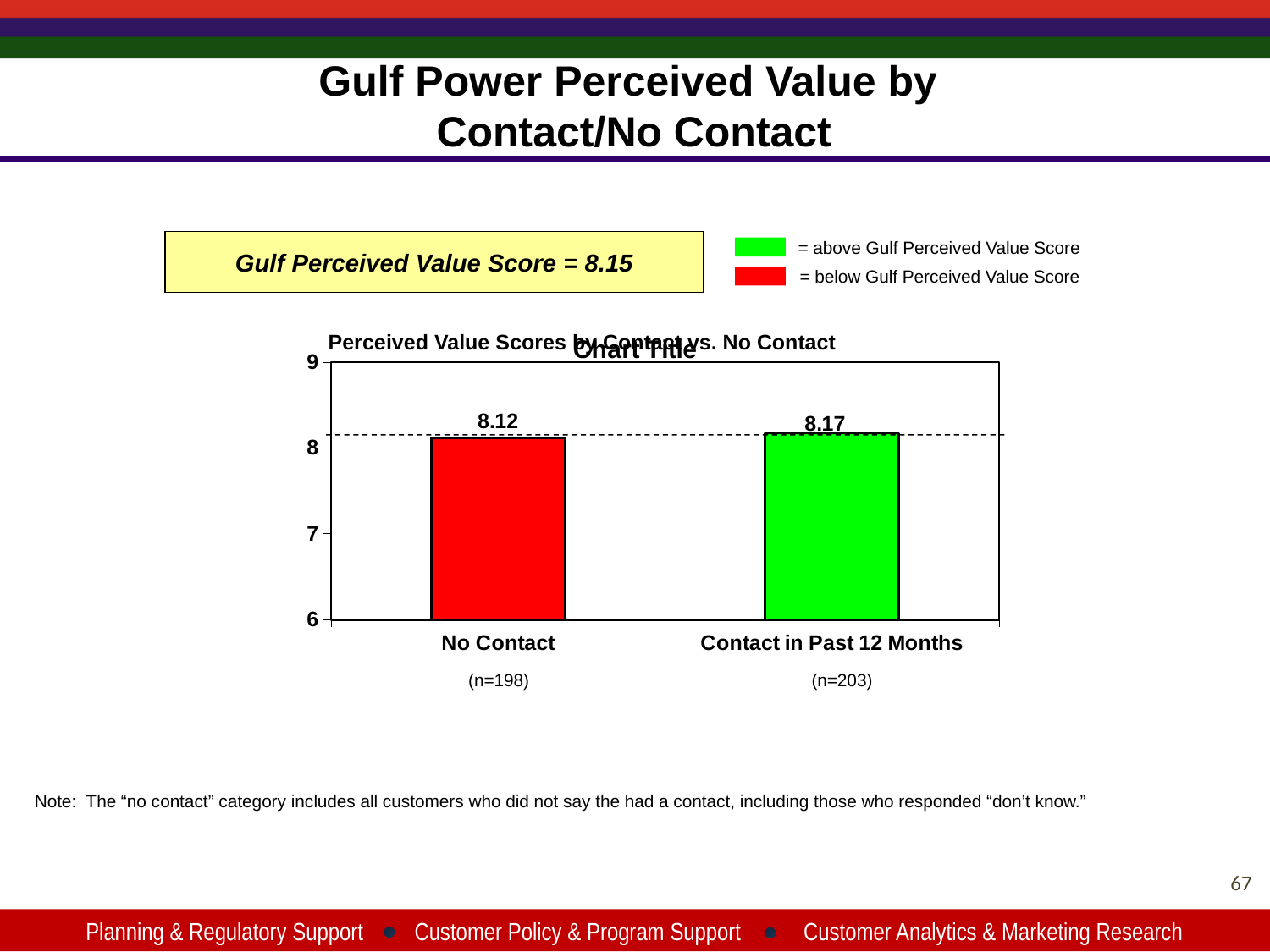
What is the perceived value score for Contact in Past 12 Months? 8.17 Is the score for No Contact larger or smaller than the score for Contact in Past 12 Months? smaller What is the perceived value score for No Contact? 8.12 What is the difference between the scores for Contact in Past 12 Months and No Contact? 0.05 Which category has the lower perceived value score? No Contact Is the value for Contact in Past 12 Months greater or less than 9? less Which category has the higher perceived value score? Contact in Past 12 Months Is the value for No Contact greater or less than 8? greater What kind of chart is shown on the slide? bar chart What is the Gulf Perceived Value Score shown in the box above the chart? 8.15 How many categories are shown on the x axis of the chart? 2 What colour is the bar for No Contact? red